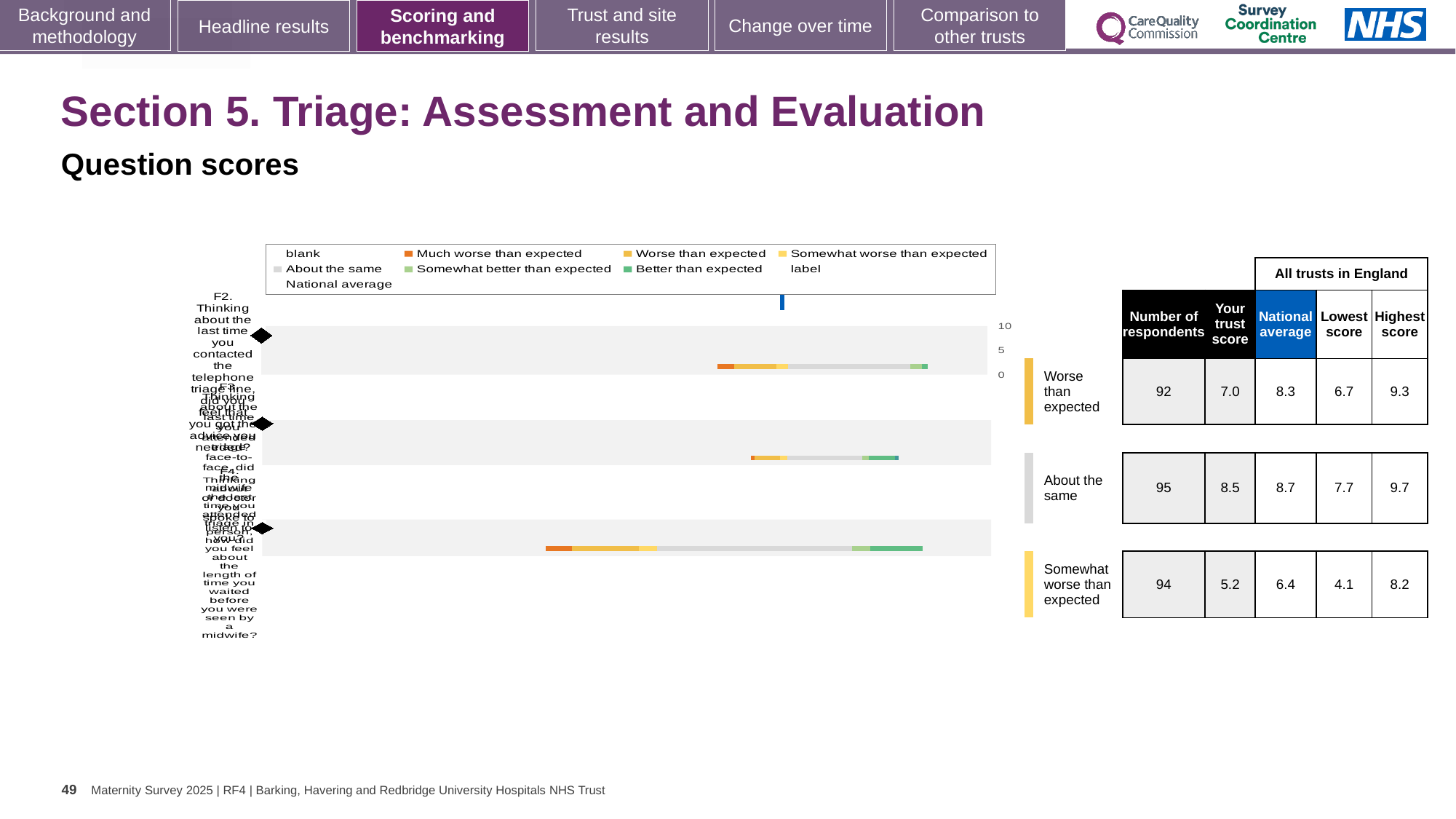
In the table beside the chart, how many respondents are listed for the row rated 'About the same'? 95 In the table beside the chart, is the trust score for the 'About the same' row larger or smaller than its national average? smaller What kind of chart is shown on the slide? bar chart In the table beside the chart, what is the national average for the row rated 'About the same'? 8.7 How many question categories (F2, F3, F4) are plotted on the chart? 3 In the table beside the chart, what is the highest score for the row rated 'Somewhat worse than expected'? 8.2 In the table beside the chart, what is the trust score for the row rated 'Worse than expected'? 7.0 In the table beside the chart, what is the trust score for the row rated 'Somewhat worse than expected'? 5.2 In the table beside the chart, which row has the highest trust score? About the same In the table beside the chart, which row has the lowest trust score? Somewhat worse than expected In the table beside the chart, what is the difference between the national average and the trust score for the row rated 'Worse than expected'? 1.3 What colour is used in the chart legend for 'Much worse than expected'? orange